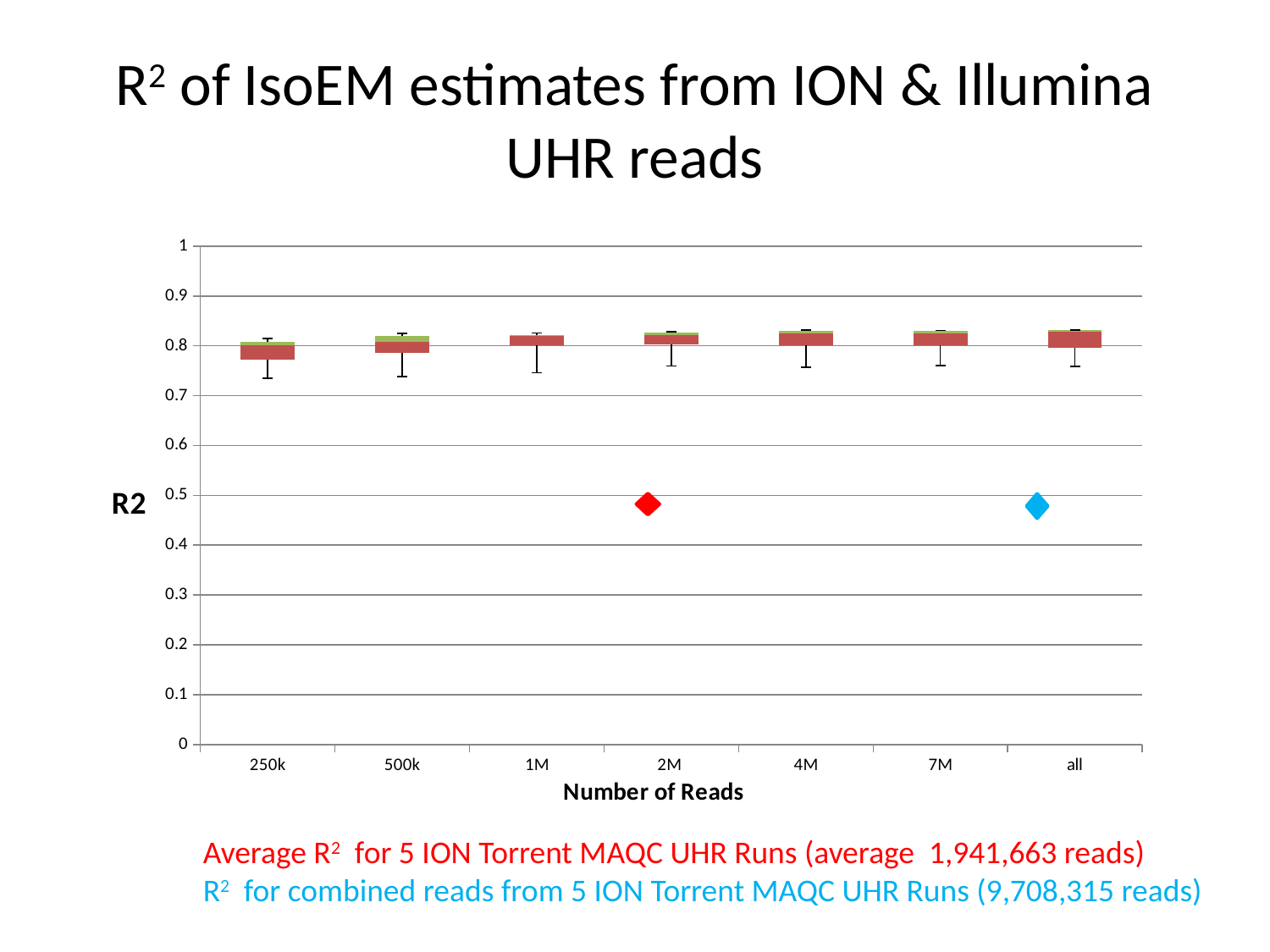
What is the maximum value shown on the y axis? 1 Is the red diamond marker (average R2 for 5 ION Torrent runs) greater or less than 0.6? less Is the box for 250k reads greater or less than 0.7? greater What is the label of the x axis? Number of Reads What is the title of the chart on the slide? R2 of IsoEM estimates from ION & Illumina UHR reads Is the blue diamond marker (R2 for combined reads) greater or less than 0.4? greater What kind of chart is shown on the slide? Box plot How many read-count categories are shown on the x axis? 7 Which is larger: the box for 'all' reads or the blue diamond marker? The box for 'all' reads Do the boxes generally rise or fall as the number of reads increases from 250k to all? rise